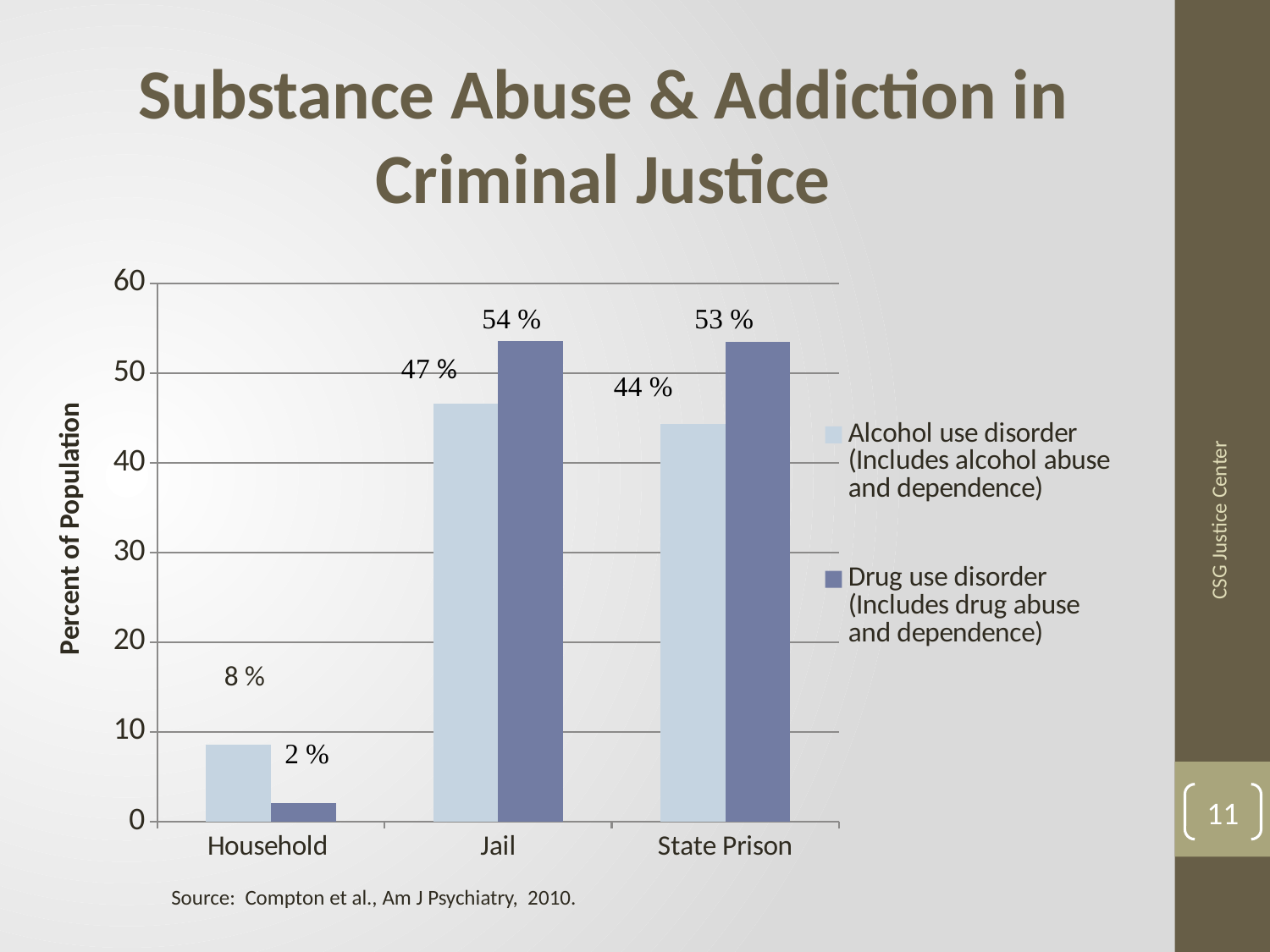
What is the value for Drug use disorder in the State Prison category? 53 % What is the value for Alcohol use disorder in the Household category? 8 % How many categories are shown on the x axis? 3 Is the Alcohol use disorder value for State Prison greater or less than 40? greater What is the value for Alcohol use disorder in the Jail category? 47 % Which is larger in the Household category: Alcohol use disorder or Drug use disorder? Alcohol use disorder Which category has the lowest Alcohol use disorder value? Household What is the difference between the Drug use disorder and Alcohol use disorder values for State Prison? 9 % Which category has the highest Drug use disorder value? Jail What kind of chart is shown on the slide? Bar chart What is the value for Drug use disorder in the Household category? 2 % How many series does the legend list? 2